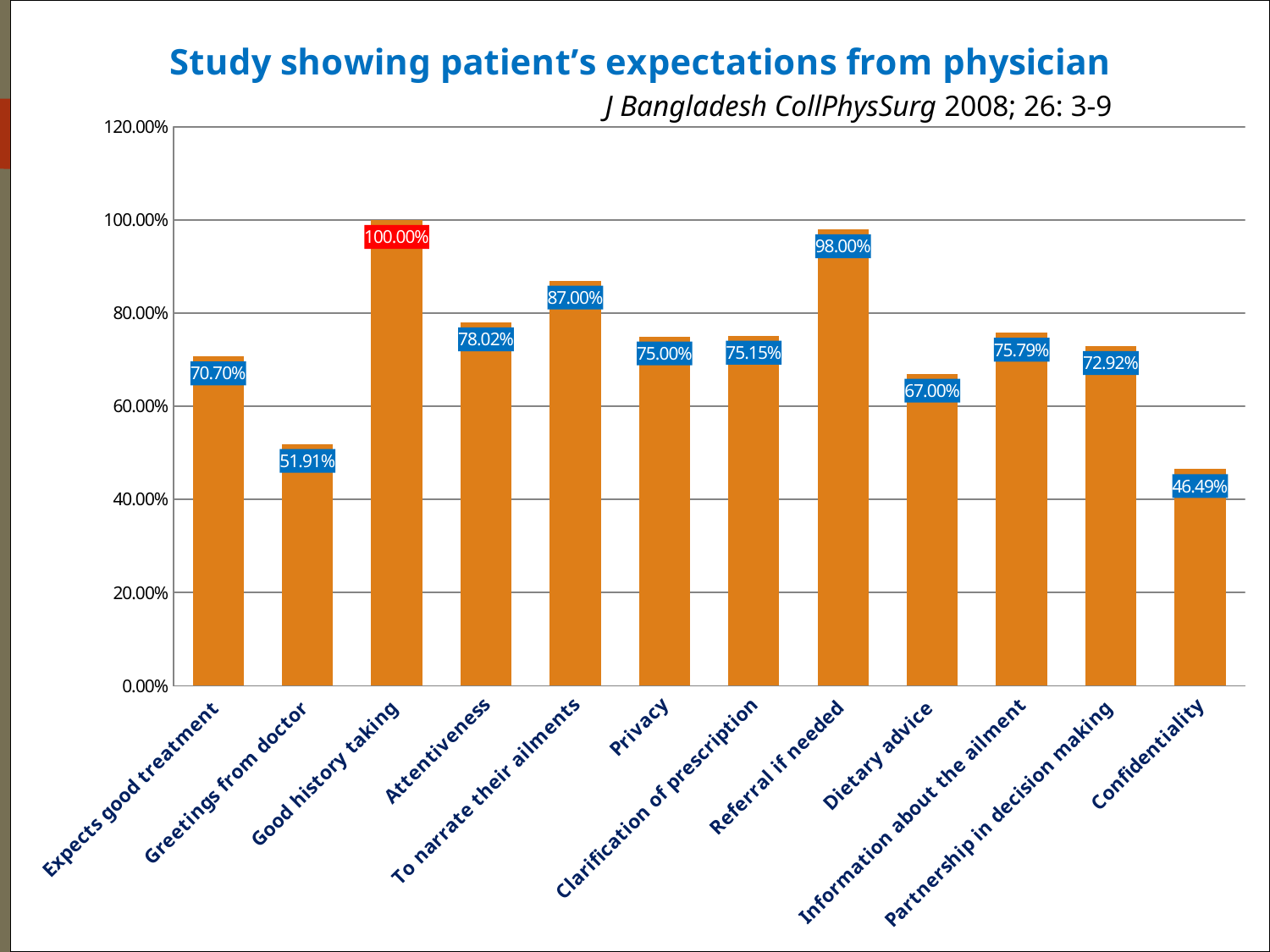
What is the value for Good history taking? 100.00% Is the value for To narrate their ailments greater or less than 80.00%? greater What is the title of the chart? Study showing patient's expectations from physician What is the value for Dietary advice? 67.00% What is the difference between the values for Referral if needed and Greetings from doctor? 46.09% How many categories are shown on the x axis? 12 What is the value for Confidentiality? 46.49% Which category has the highest value? Good history taking Which data label is shown with a red background instead of blue? 100.00% (Good history taking) What kind of chart is shown on the slide? bar chart Which is larger, the value for Attentiveness or the value for Partnership in decision making? Attentiveness Which category has the lowest value? Confidentiality